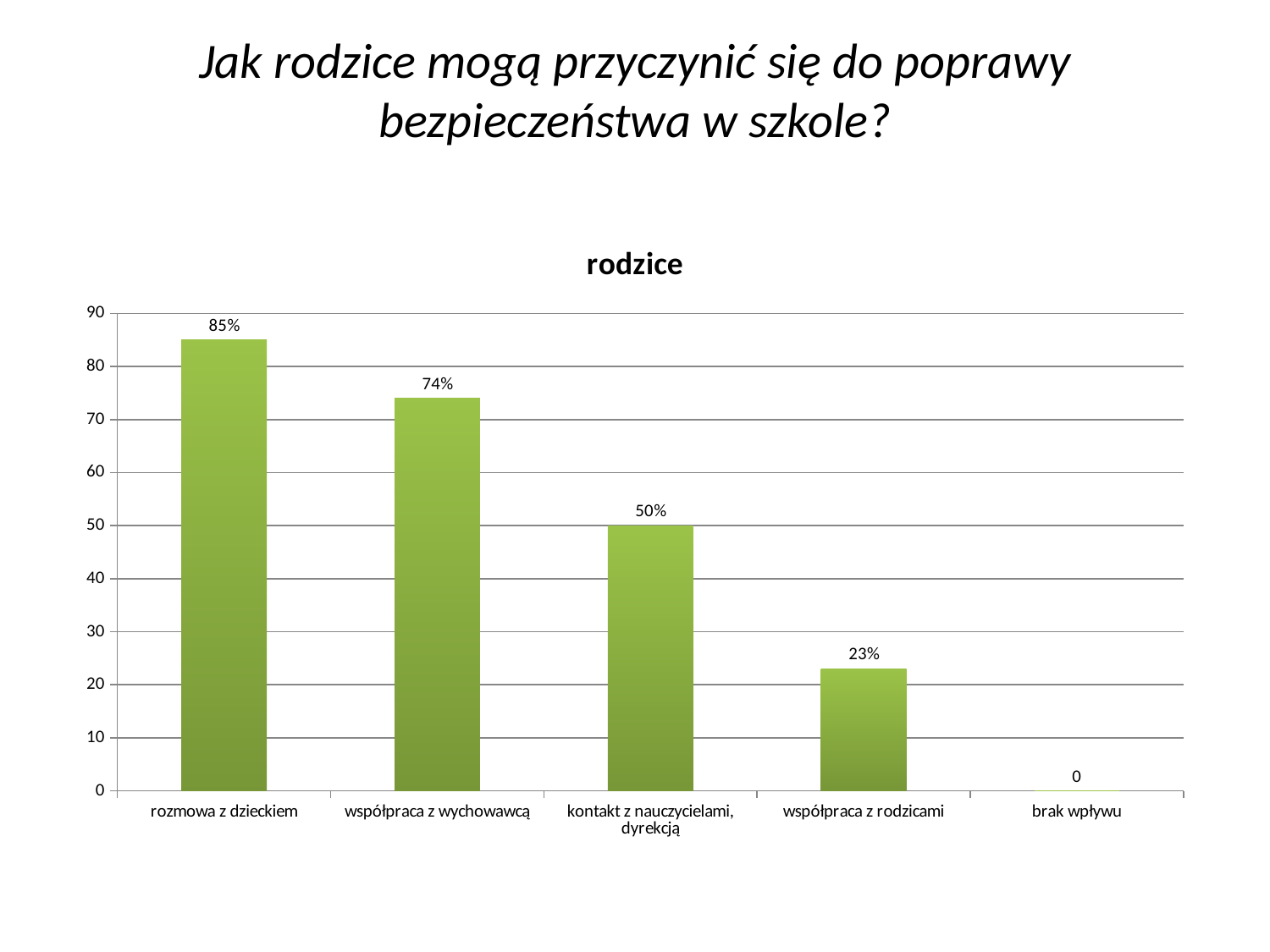
Which category has the lowest value? brak wpływu Which category has the highest value? rozmowa z dzieckiem Which is larger, the value for "kontakt z nauczycielami, dyrekcją" or the value for "współpraca z rodzicami"? kontakt z nauczycielami, dyrekcją What is the title of the chart? rodzice What is the value for "rozmowa z dzieckiem"? 85% How many categories are shown on the x axis? 5 What is the value for "współpraca z wychowawcą"? 74% What is the value for "współpraca z rodzicami"? 23% What is the value for "kontakt z nauczycielami, dyrekcją"? 50% What is the difference between the values for "rozmowa z dzieckiem" and "współpraca z wychowawcą"? 11% What is the value for "brak wpływu"? 0 What kind of chart is shown on the slide? bar chart